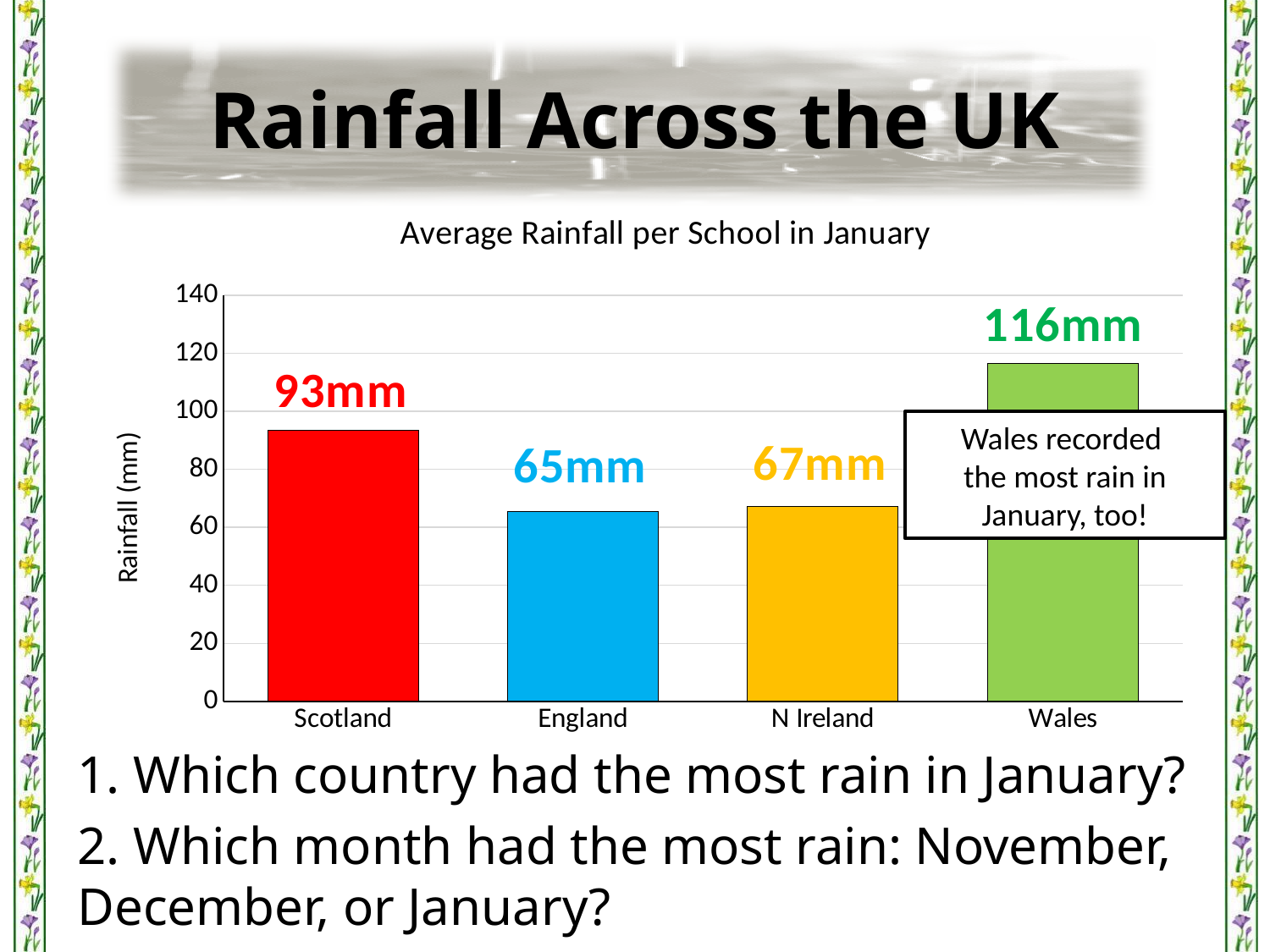
What is the average rainfall for Scotland in January? 93mm What is the difference in rainfall between Wales and Scotland? 23mm What is the average rainfall for England in January? 65mm Which has more rainfall, Scotland or N Ireland? Scotland What is the average rainfall for Wales in January? 116mm What is the difference in rainfall between N Ireland and England? 2mm How many countries are shown on the chart? 4 What is the title of the chart? Average Rainfall per School in January Is the value for Wales greater or less than 100? greater Which country has the lowest average rainfall in January? England Which country has the highest average rainfall in January? Wales What kind of chart is shown on the slide? bar chart